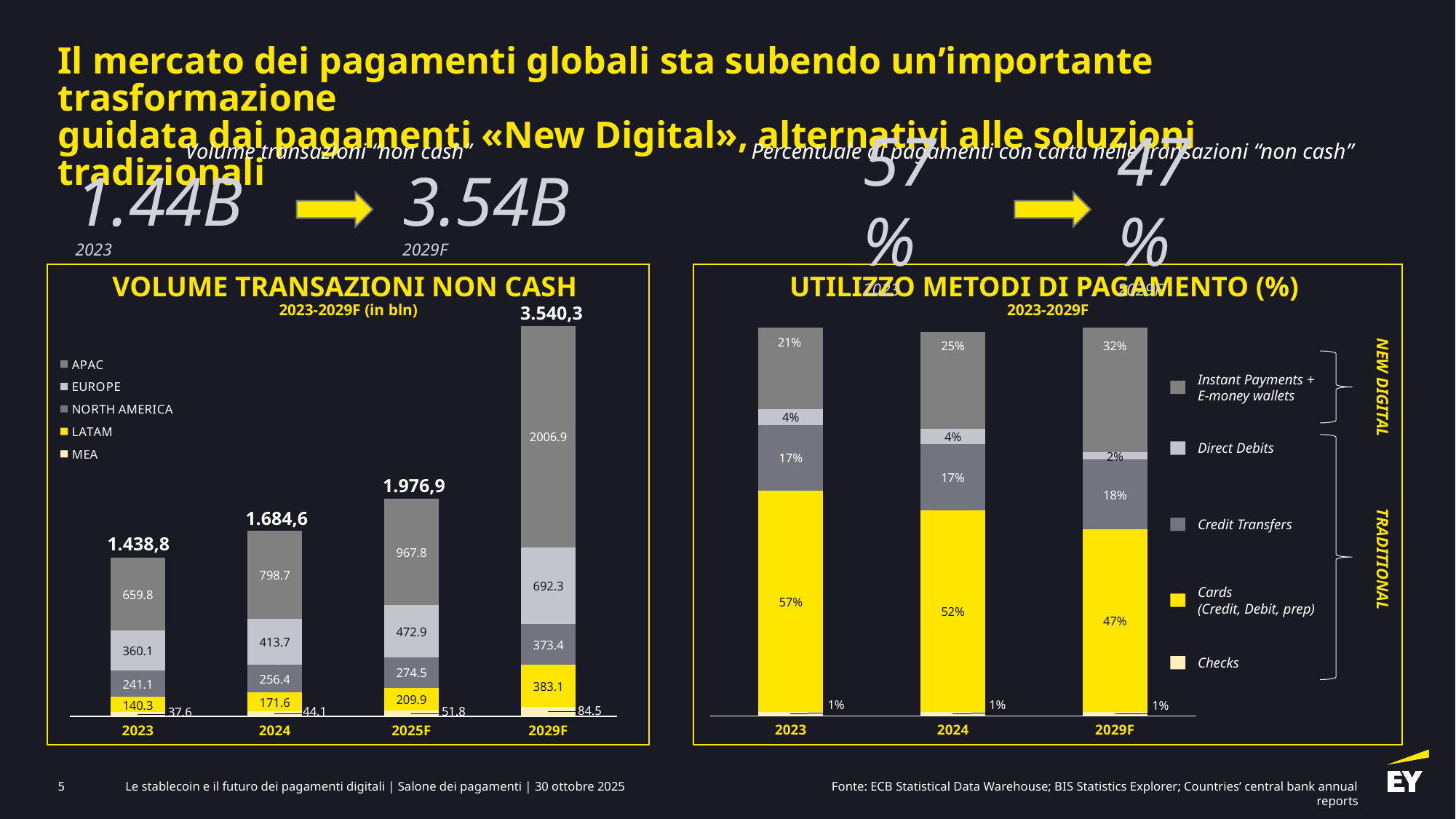
In the 'UTILIZZO METODI DI PAGAMENTO (%)' chart, which is larger in 2023: Credit Transfers or Direct Debits? Credit Transfers In the 'VOLUME TRANSAZIONI NON CASH' chart, what is the total value shown for 2029F? 3.540,3 In the 'UTILIZZO METODI DI PAGAMENTO (%)' chart, what is the Instant Payments + E-money wallets share for 2029F? 32% In the 'UTILIZZO METODI DI PAGAMENTO (%)' chart, does the Cards share rise or fall from 2023 to 2029F? fall In the 'VOLUME TRANSAZIONI NON CASH' chart, which year has the lowest total? 2023 In the 'VOLUME TRANSAZIONI NON CASH' chart, what is the difference between the EUROPE values for 2025F and 2024? 59.2 In the 'VOLUME TRANSAZIONI NON CASH' chart, what is the LATAM value for 2029F? 383.1 In the 'UTILIZZO METODI DI PAGAMENTO (%)' chart, what is the Cards share for 2024? 52% In the 'VOLUME TRANSAZIONI NON CASH' chart, how many series does the legend list? 5 What kind of chart is 'UTILIZZO METODI DI PAGAMENTO (%)'? stacked bar chart In the 'VOLUME TRANSAZIONI NON CASH' chart, what is the APAC value for 2024? 798.7 In the 'VOLUME TRANSAZIONI NON CASH' chart, how many years are shown on the x axis? 4